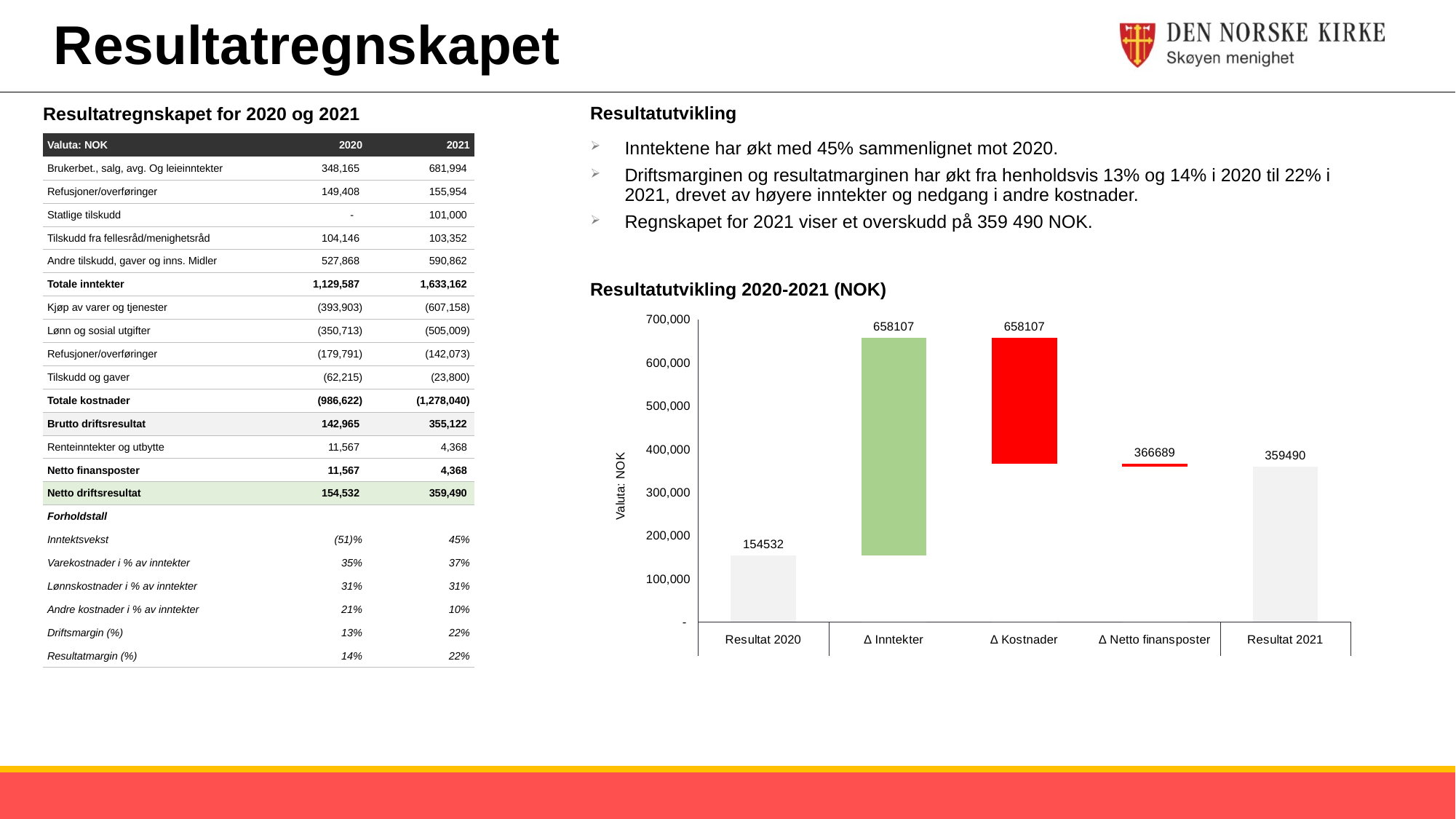
In the Resultatutvikling 2020-2021 (NOK) chart, what is the difference between the Resultat 2021 and Resultat 2020 values? 204958 What is the value shown for Resultat 2021 in the Resultatutvikling 2020-2021 (NOK) chart? 359490 What kind of chart is the Resultatutvikling 2020-2021 (NOK) chart? bar chart What value is labelled on the Δ Netto finansposter bar in the Resultatutvikling 2020-2021 (NOK) chart? 366689 What is the y-axis title of the Resultatutvikling 2020-2021 (NOK) chart? Valuta: NOK What value is labelled above the Δ Inntekter bar in the Resultatutvikling 2020-2021 (NOK) chart? 658107 In the Resultatutvikling 2020-2021 (NOK) chart, what colour is the Δ Kostnader bar? red What is the value shown for Resultat 2020 in the Resultatutvikling 2020-2021 (NOK) chart? 154532 In the Resultatutvikling 2020-2021 (NOK) chart, which is larger: Resultat 2020 or Resultat 2021? Resultat 2021 In the Resultatutvikling 2020-2021 (NOK) chart, which category has the lowest labelled value? Resultat 2020 How many categories are shown on the x axis of the Resultatutvikling 2020-2021 (NOK) chart? 5 In the Resultatutvikling 2020-2021 (NOK) chart, is the value for Resultat 2020 greater or less than 200,000? less